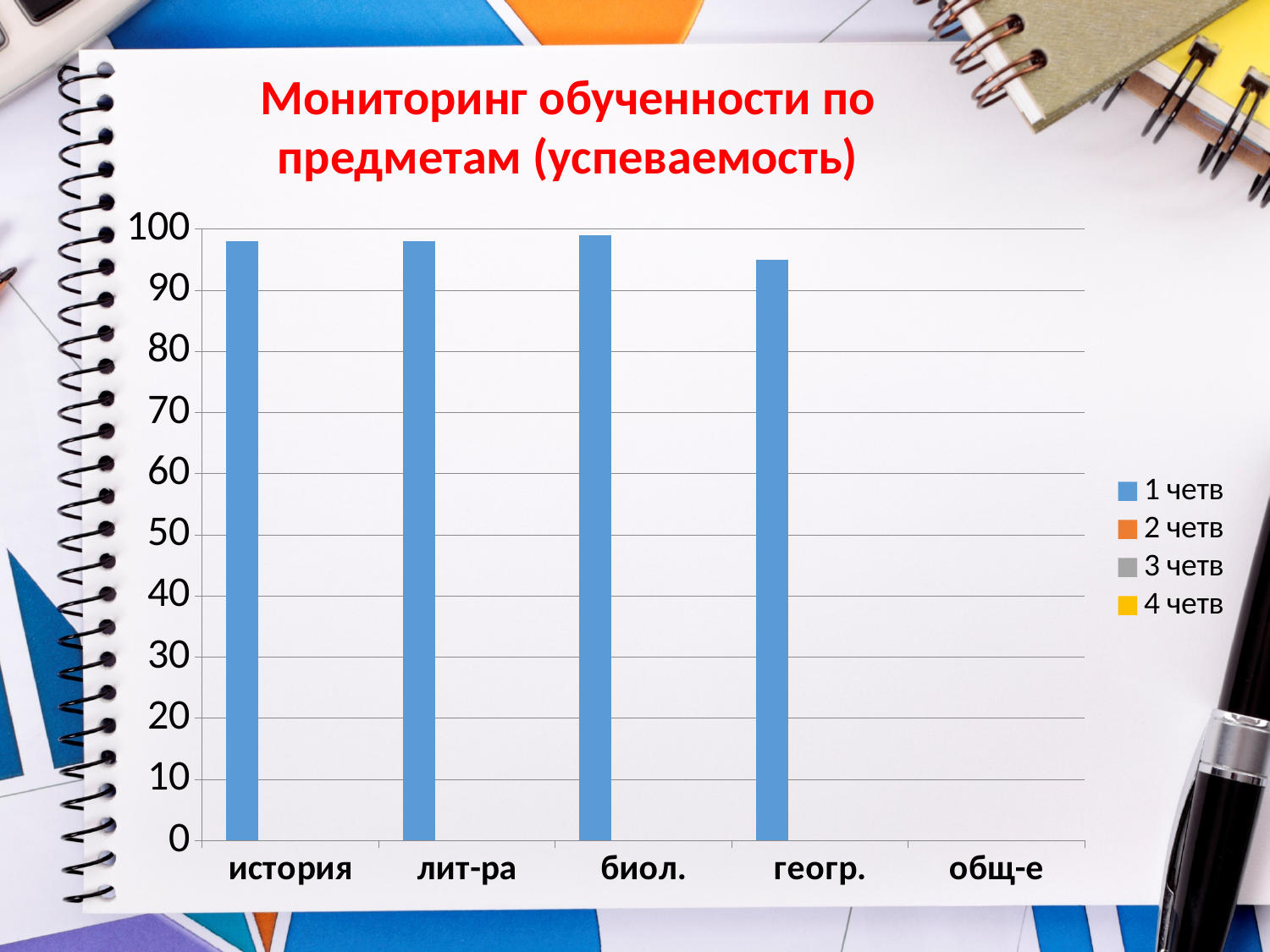
Is the value for история in the 1 четв series greater or less than 90? greater What is the title of the chart? Мониторинг обученности по предметам (успеваемость) How many categories are shown on the x axis? 5 Which has the larger 1 четв value, биол. or геогр.? биол. Which series is shown in blue in the legend? 1 четв What kind of chart is shown on the slide? bar chart Is the value for лит-ра in the 1 четв series greater or less than 100? less Among the categories with a plotted bar, which has the lowest 1 четв value? геогр. Which has the larger 1 четв value, история or геогр.? история Is the value for биол. in the 1 четв series greater or less than 80? greater How many series does the legend list? 4